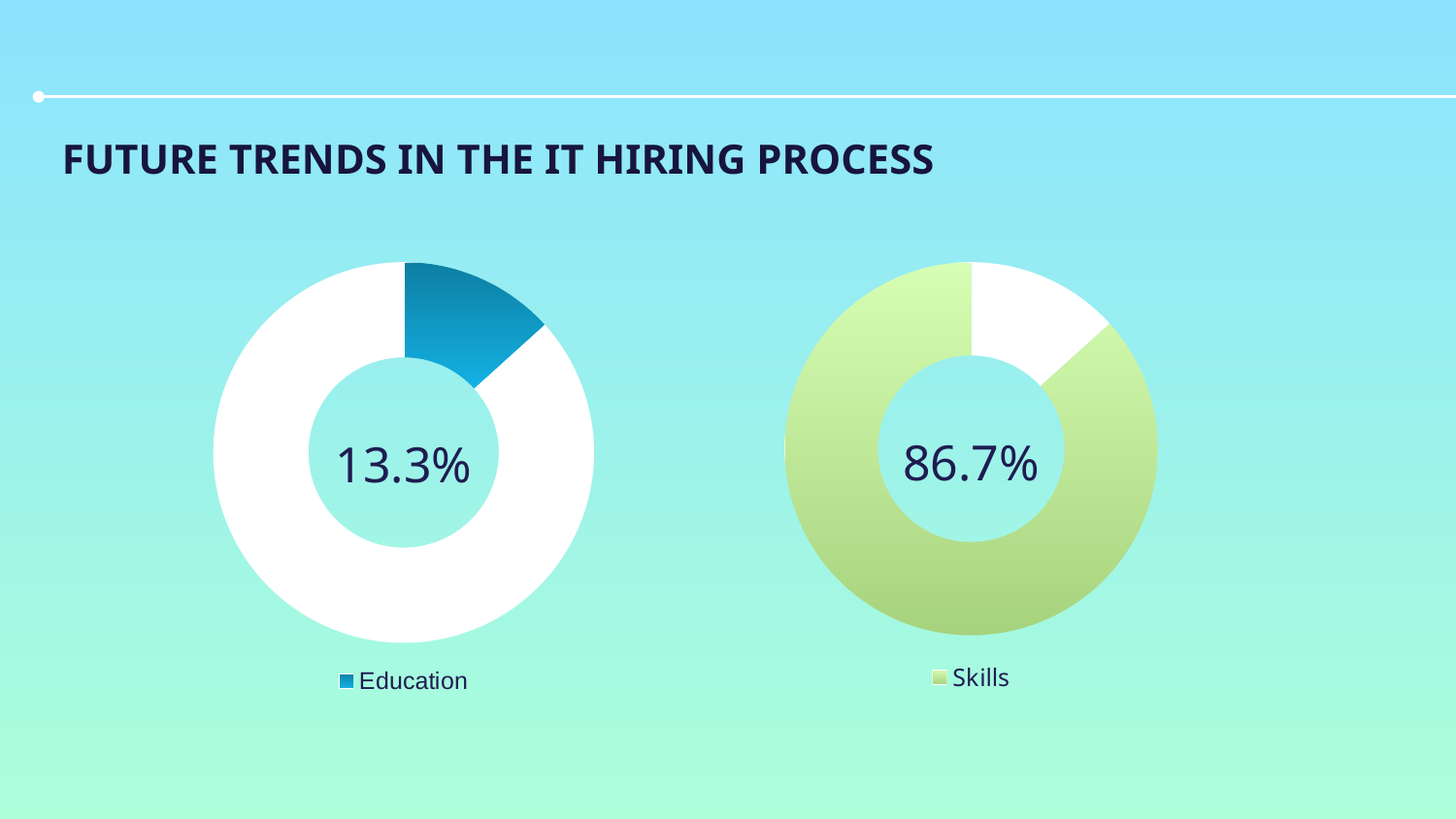
What is the title of the slide containing the two charts? FUTURE TRENDS IN THE IT HIRING PROCESS What is the legend entry of the left chart? Education On the right chart, what percentage is shown for Skills? 86.7% Which is larger, the Education value on the left chart or the Skills value on the right chart? Skills On the right chart, is the Skills value greater or less than 50%? greater What is the difference between the Skills value on the right chart and the Education value on the left chart? 73.4% How many series does the legend of the left chart list? 1 What kind of chart is the left chart on the slide? Doughnut chart What kind of chart is the right chart on the slide? Doughnut chart On the left chart, is the Education value greater or less than 50%? less On the left chart, what percentage is shown for Education? 13.3% How many series does the legend of the right chart list? 1